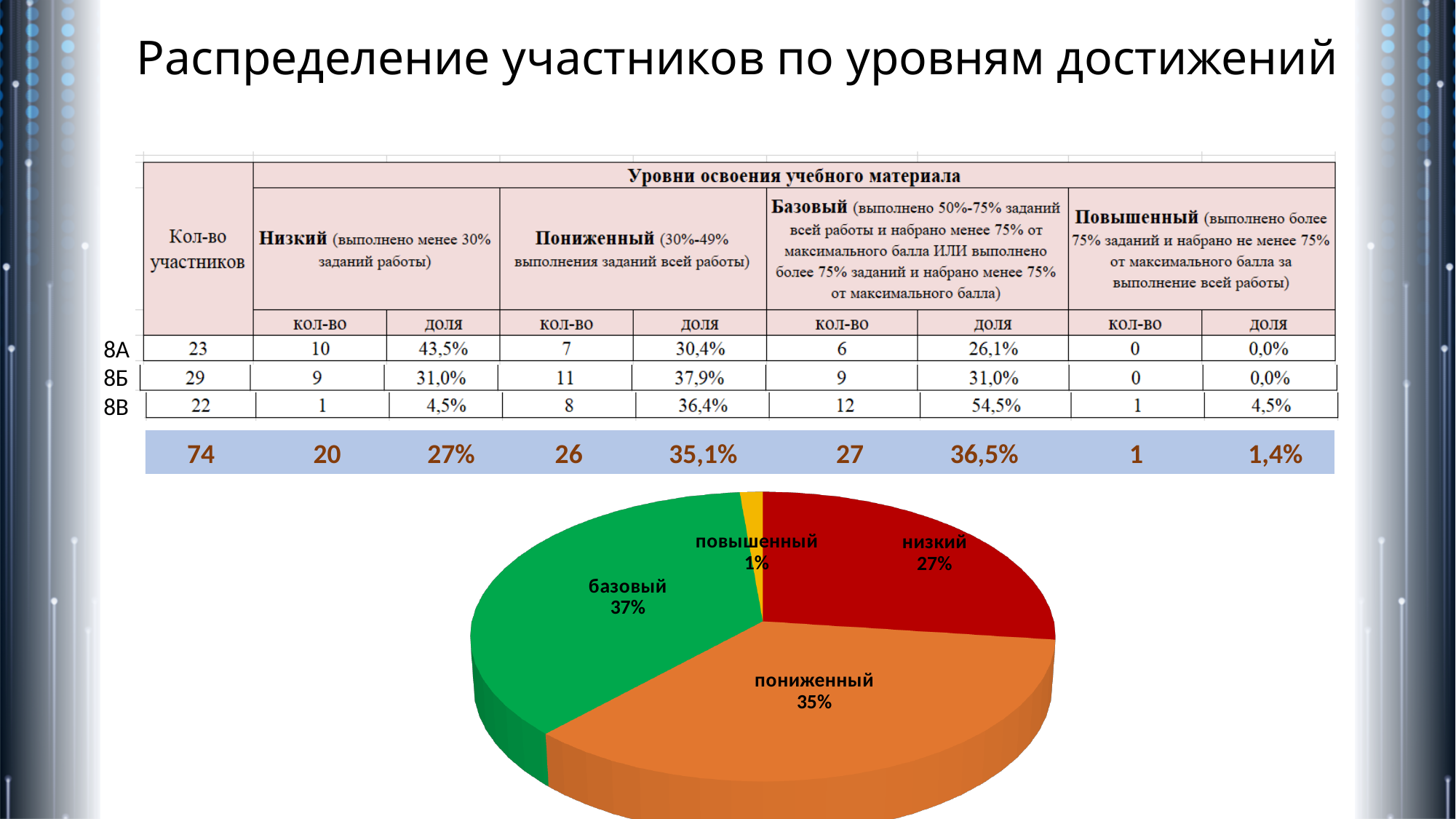
Which slice of the pie chart is the largest? базовый What colour is the "базовый" slice in the pie chart? Green Which slice of the pie chart is the smallest? повышенный In the pie chart, which is larger: the "низкий" slice or the "пониженный" slice? пониженный What share of the pie chart does the "повышенный" slice represent? 1% What share of the pie chart does the "пониженный" slice represent? 35% What type of chart is shown on the slide? Pie chart By how many percentage points does the "низкий" slice exceed the "повышенный" slice in the pie chart? 26 percentage points How many slices does the pie chart have? 4 What share of the pie chart does the "низкий" slice represent? 27% By how many percentage points does the "базовый" slice exceed the "пониженный" slice in the pie chart? 2 percentage points